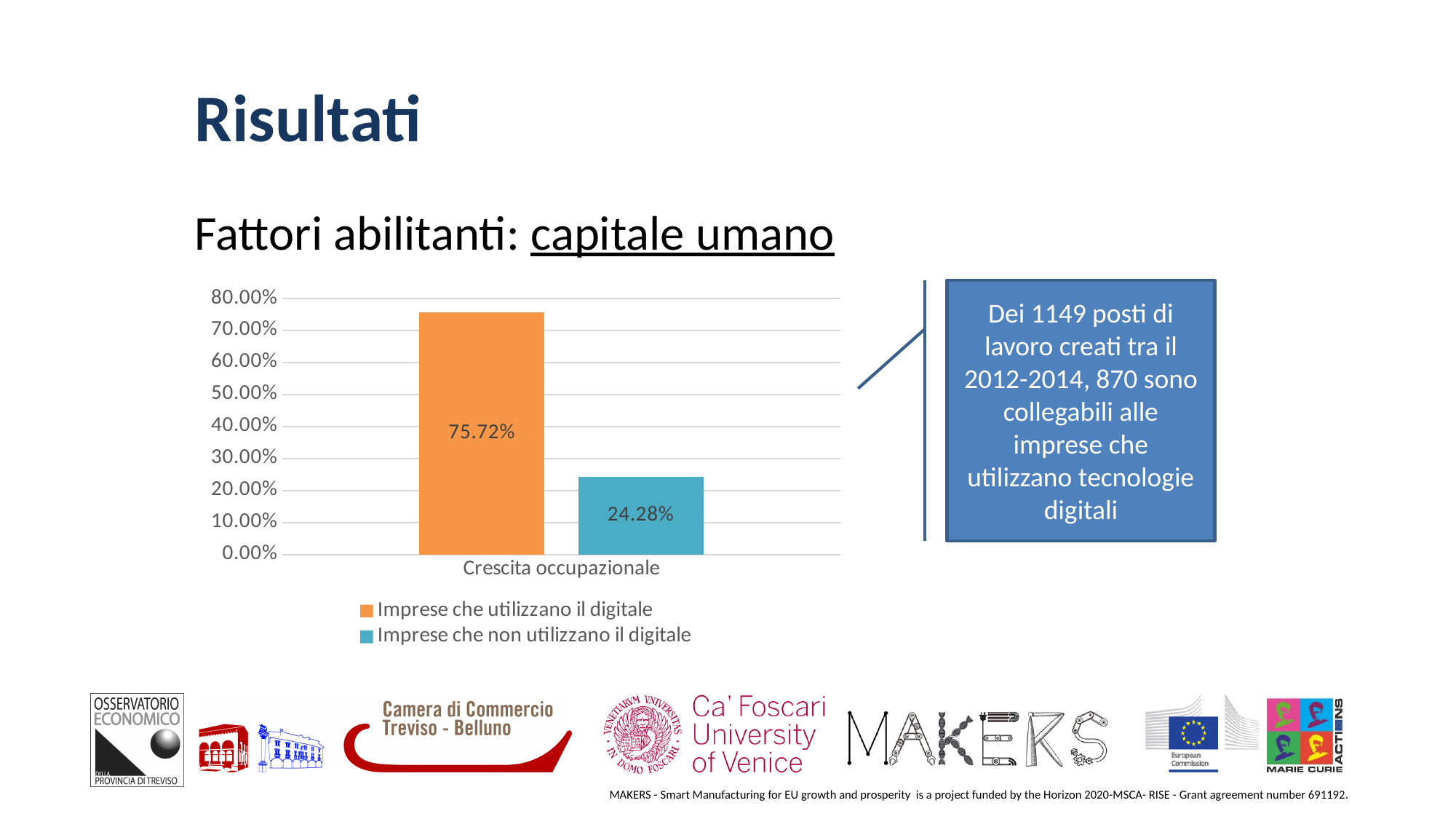
Which series has the lower value for Crescita occupazionale? Imprese che non utilizzano il digitale Is the value for 'Imprese che utilizzano il digitale' larger or smaller than the value for 'Imprese che non utilizzano il digitale'? larger What is the category label on the x axis of the chart? Crescita occupazionale Is the value for 'Imprese che non utilizzano il digitale' greater or less than 30.00%? less How many series does the legend list? 2 What kind of chart is shown on the slide? bar chart Is the value for 'Imprese che utilizzano il digitale' greater or less than 70.00%? greater What is the difference between the values for 'Imprese che utilizzano il digitale' and 'Imprese che non utilizzano il digitale'? 51.44% What is the value for 'Imprese che utilizzano il digitale' in the Crescita occupazionale chart? 75.72% Which series has the higher value for Crescita occupazionale? Imprese che utilizzano il digitale What is the value for 'Imprese che non utilizzano il digitale' in the Crescita occupazionale chart? 24.28% How many categories are shown on the x axis of the chart? 1